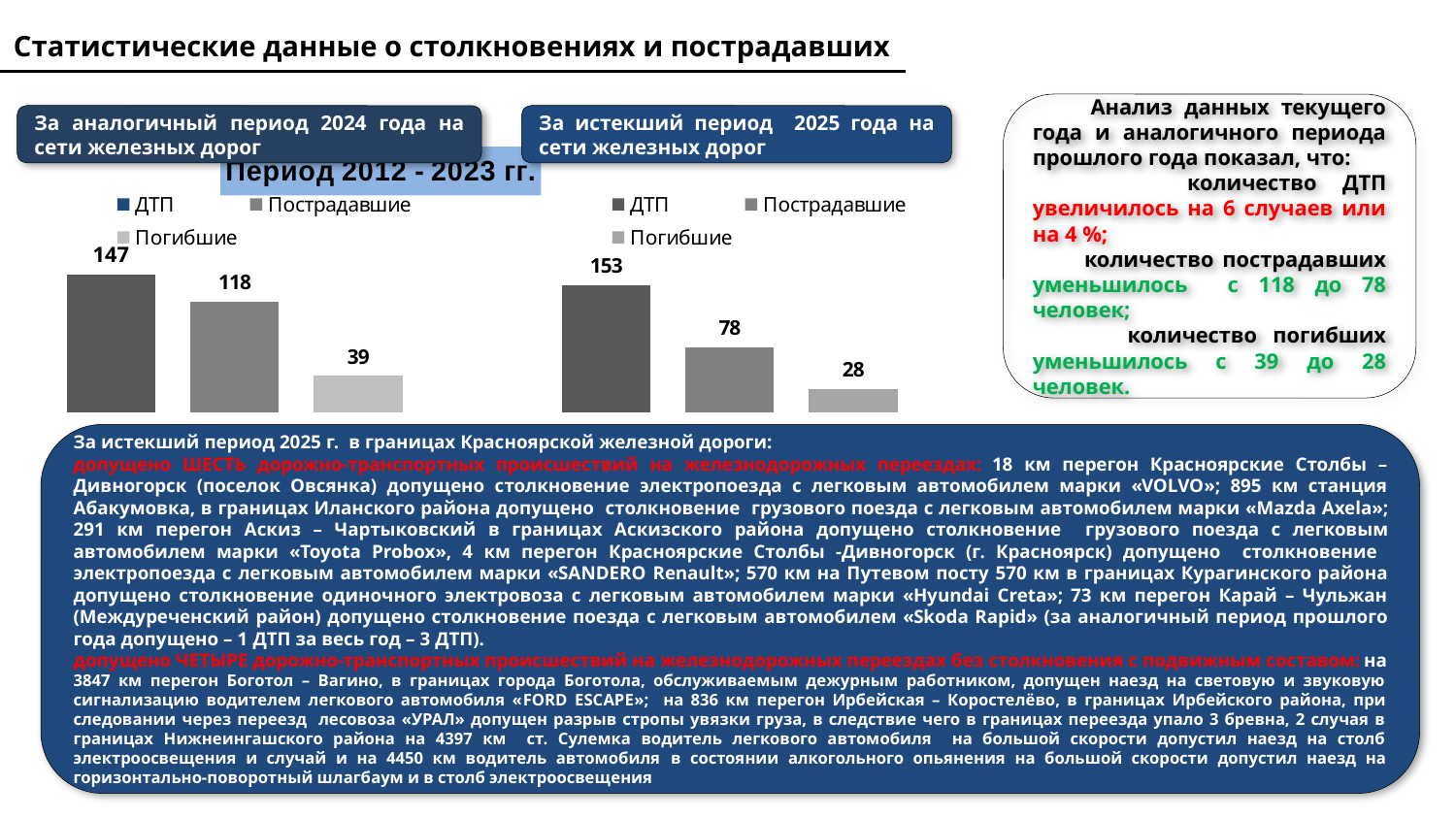
On the left chart (2024 period), which category has the highest value? ДТП On the right chart (2025 period), what is the value for ДТП? 153 Which is larger: ДТП on the left chart (2024) or ДТП on the right chart (2025)? ДТП on the right chart (2025), 153 On the left chart (2024 period), what is the value for Пострадавшие? 118 How many legend entries does the right chart (2025 period) list? 3 On the left chart (2024 period), what is the value for Погибшие? 39 On the right chart (2025 period), which category has the lowest value? Погибшие What type of chart is the left chart (2024 period)? Bar chart On the right chart (2025 period), what is the value for Пострадавшие? 78 On the left chart (2024 period), what is the value for ДТП? 147 What is the difference between Пострадавшие on the left chart (2024) and Пострадавшие on the right chart (2025)? 40 On the right chart (2025 period), what is the value for Погибшие? 28